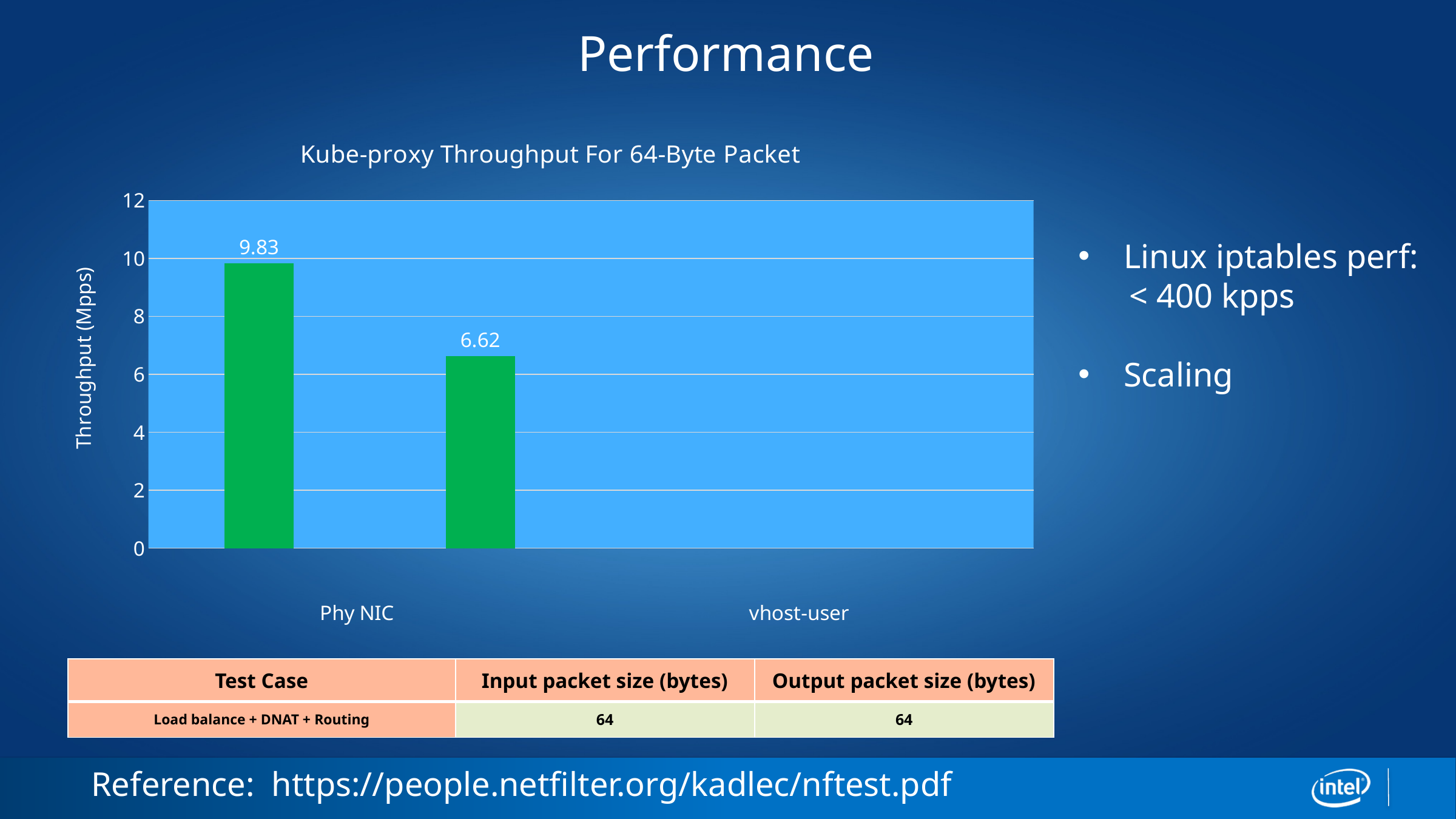
Which has a larger throughput, Phy NIC or vhost-user? Phy NIC What is the title of the chart? Kube-proxy Throughput For 64-Byte Packet What kind of chart is shown on the slide? bar chart What is the difference in throughput between Phy NIC and vhost-user? 3.21 Which category has the lowest throughput? vhost-user Is the throughput for vhost-user greater or less than 8? less What is the throughput value for vhost-user? 6.62 What is the label of the y axis? Throughput (Mpps) Which category has the highest throughput? Phy NIC Is the throughput for Phy NIC greater or less than 8? greater How many categories are shown in the chart? 2 What is the throughput value for Phy NIC? 9.83